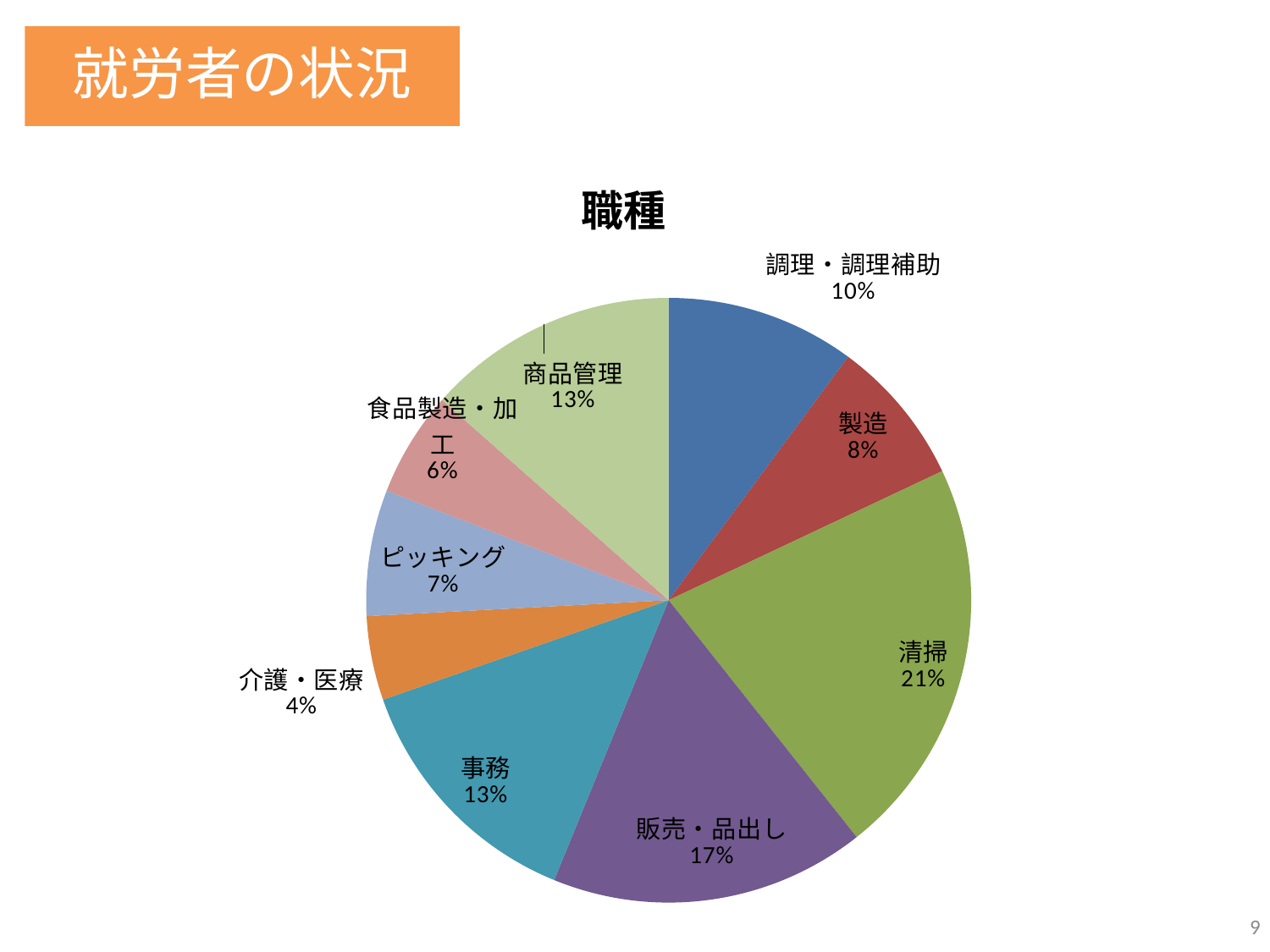
Which category has the smallest share of the pie? 介護・医療 What is the value for 調理・調理補助? 10% Which category has the largest share of the pie? 清掃 How many categories are shown in the pie chart? 9 What kind of chart is shown on the slide? pie chart What is the difference between the shares of 清掃 and 製造? 13% Which is larger, the share of 事務 or the share of 食品製造・加工? 事務 What is the value for 介護・医療? 4% What is the value for 販売・品出し? 17% What is the value for ピッキング? 7% What is the title of the chart? 職種 What share of the pie does 清掃 have? 21%